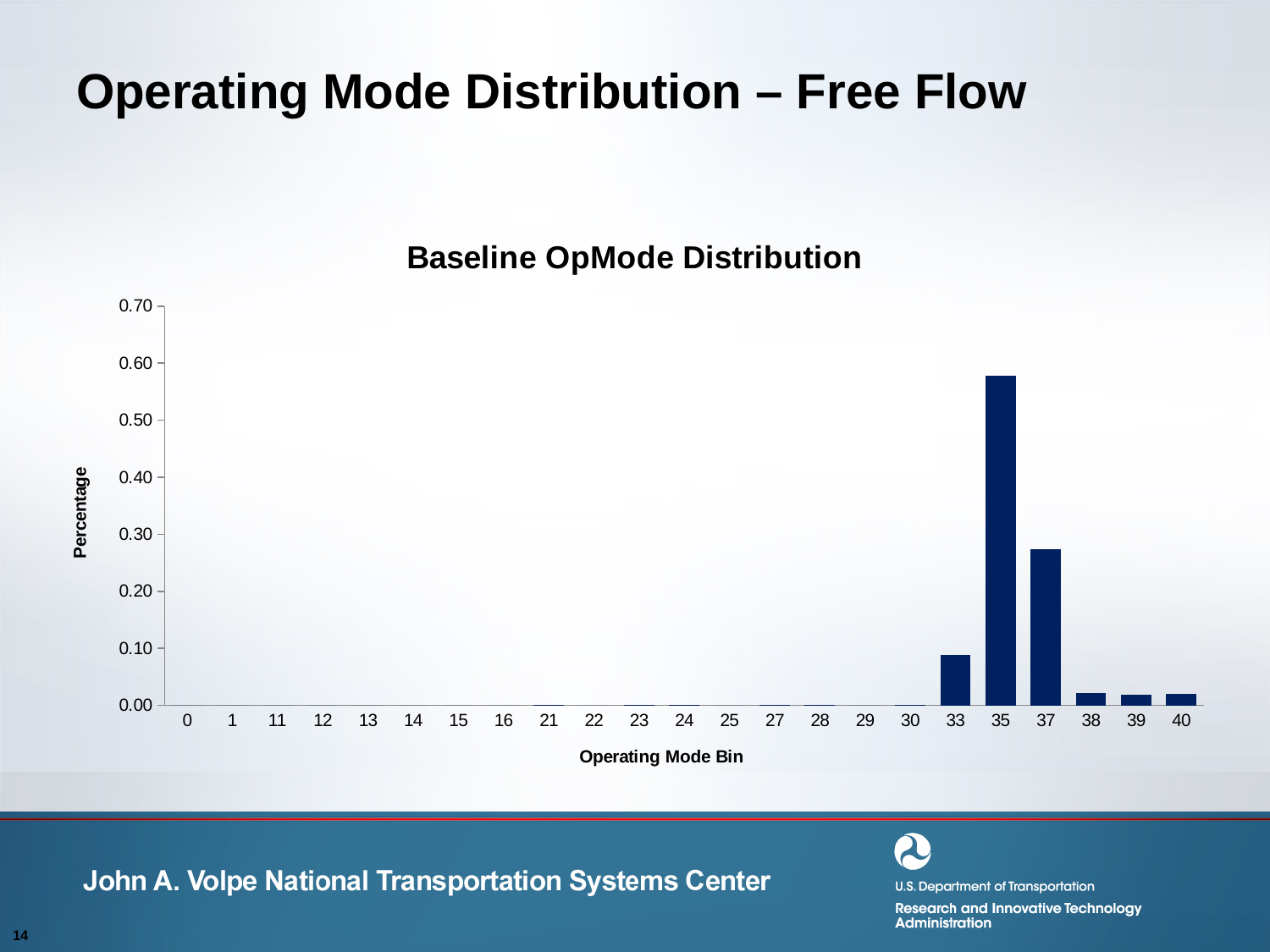
Which operating mode bin has the highest percentage? 35 What is the label of the x axis? Operating Mode Bin Is the value for operating mode bin 35 greater or less than 0.60? less What kind of chart is shown on the slide? bar chart Which has a higher percentage, operating mode bin 33 or bin 37? 37 What is the title of the chart? Baseline OpMode Distribution Which has a higher percentage, operating mode bin 35 or bin 37? 35 Is the value for operating mode bin 35 greater or less than 0.50? greater How many operating mode bins are shown on the x axis? 23 Is the value for operating mode bin 37 greater or less than 0.20? greater